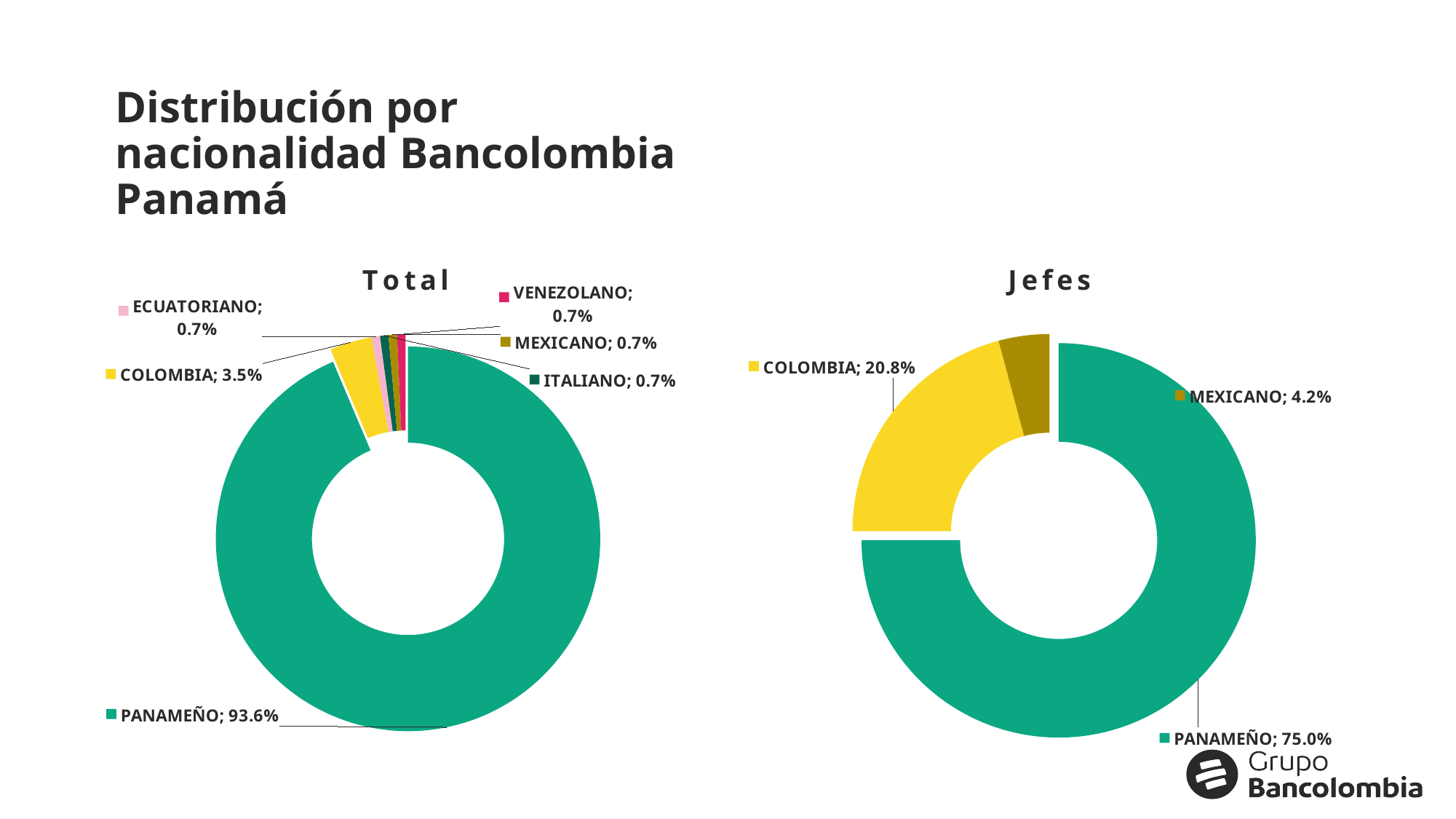
In the 'Jefes' chart, how many categories are shown? 3 In the 'Jefes' chart, what is the difference between the PANAMEÑO and COLOMBIA shares? 54.2% In the 'Total' chart, what share does COLOMBIA have? 3.5% In the 'Total' chart, what share does PANAMEÑO have? 93.6% In the 'Total' chart, what share does ECUATORIANO have? 0.7% What kind of chart is the 'Jefes' chart? Pie (doughnut) chart In the 'Jefes' chart, what share does MEXICANO have? 4.2% In the 'Total' chart, which category has the largest share? PANAMEÑO In the 'Total' chart, how many categories are shown? 6 In the 'Jefes' chart, which category has the smallest share? MEXICANO Which is larger: the COLOMBIA share in the 'Total' chart or the COLOMBIA share in the 'Jefes' chart? Jefes In the 'Jefes' chart, what share does COLOMBIA have? 20.8%